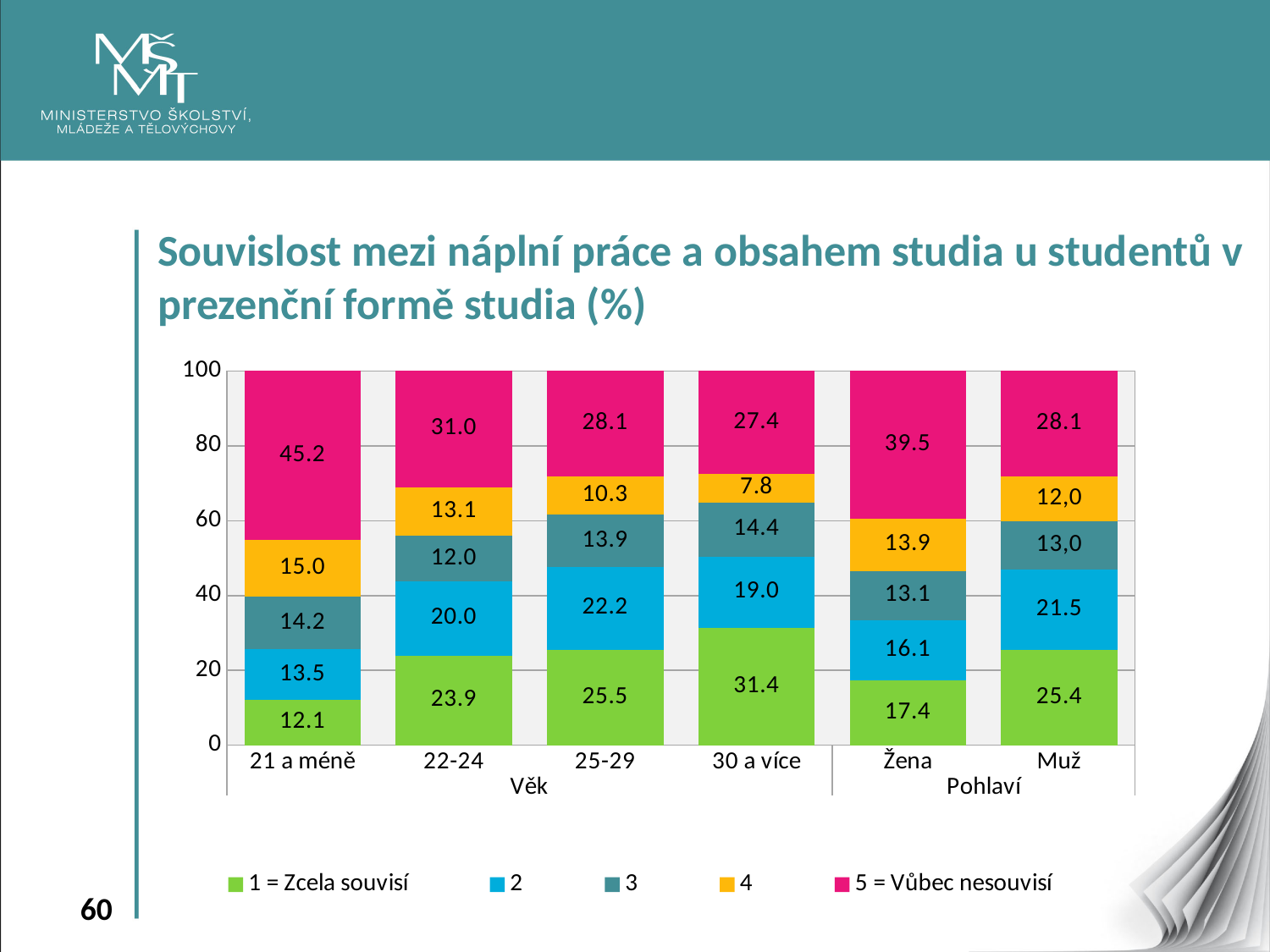
What is the value of series "4" for the "Žena" category? 13.9 What is the value of "5 = Vůbec nesouvisí" for the "21 a méně" category? 45.2 What is the difference between the "5 = Vůbec nesouvisí" values for "Žena" and "Muž"? 11.4 What is the value of series "2" for the "Muž" category? 21.5 What is the value of "1 = Zcela souvisí" for the "30 a více" category? 31.4 Across the age categories from "21 a méně" to "30 a více", do the values for "1 = Zcela souvisí" rise or fall? Rise What kind of chart is shown on the slide? Stacked bar chart Which category has the highest value for "5 = Vůbec nesouvisí"? 21 a méně Which is larger: the "1 = Zcela souvisí" value for "22-24" or for "25-29"? 25-29 Which category has the lowest value for "1 = Zcela souvisí"? 21 a méně How many categories are shown on the x axis? 6 How many series does the legend list? 5